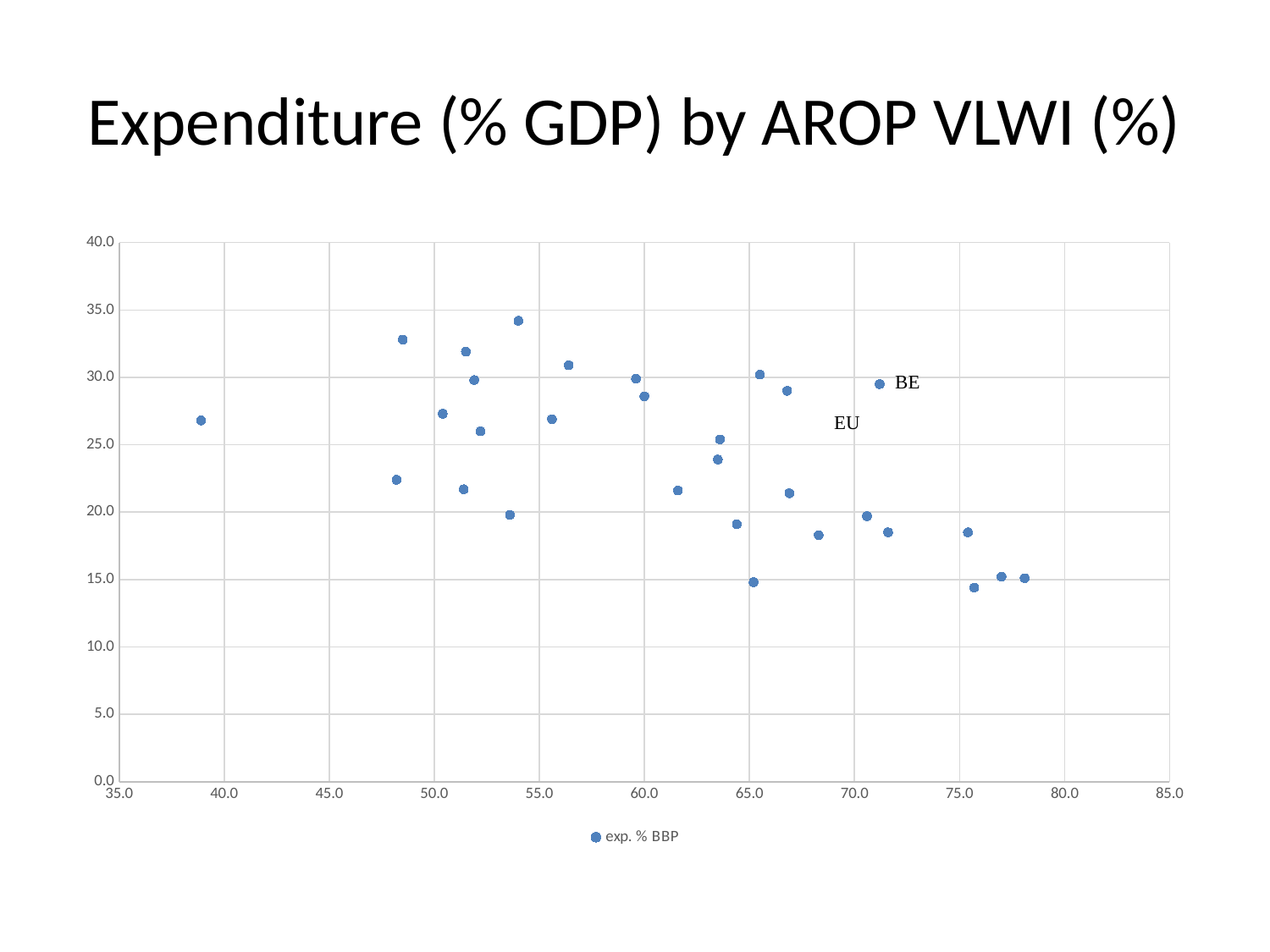
Is the y value of the lowest point on the chart greater or less than 20.0? less Is the y value of the leftmost point on the chart greater or less than 25.0? greater Is the x value of the rightmost point on the chart greater or less than 75.0? greater How many series does the legend list? 1 What is the legend entry for the plotted series? exp. % BBP What is the title of the chart? Expenditure (% GDP) by AROP VLWI (%) What kind of chart is shown on the slide? scatter chart Do the plotted values generally rise or fall as the x-axis value increases? fall